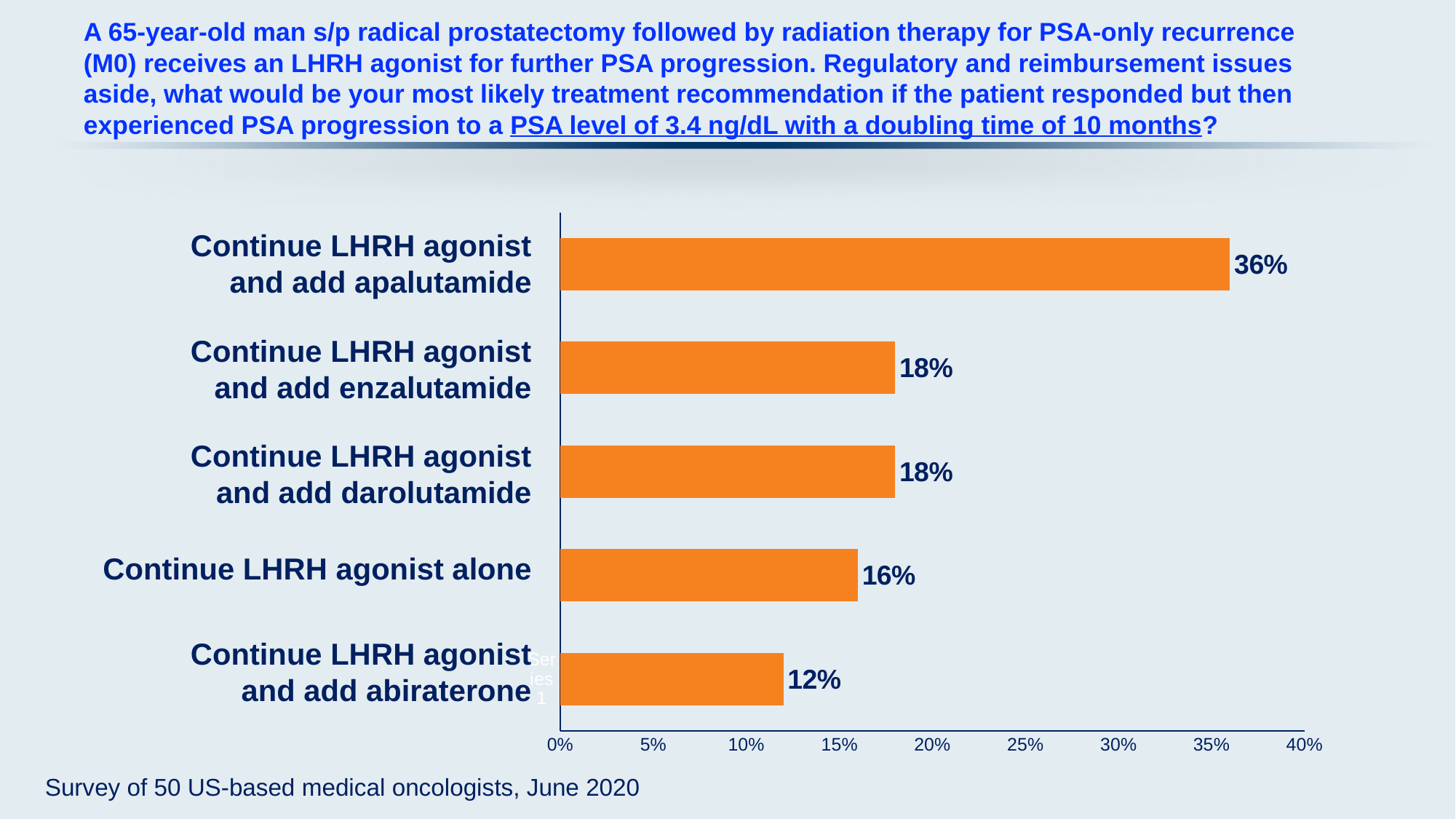
Which treatment recommendation has the lowest percentage? Continue LHRH agonist and add abiraterone What is the maximum value shown on the horizontal axis? 40% What percentage of respondents chose 'Continue LHRH agonist and add apalutamide'? 36% Is the value for 'Continue LHRH agonist and add apalutamide' greater or less than 30%? greater What is the value for 'Continue LHRH agonist and add darolutamide'? 18% What is the value for 'Continue LHRH agonist alone'? 16% Which is larger: the value for 'Continue LHRH agonist alone' or 'Continue LHRH agonist and add abiraterone'? Continue LHRH agonist alone What is the value for 'Continue LHRH agonist and add abiraterone'? 12% How many treatment options are shown in the chart? 5 What kind of chart is shown on the slide? Bar chart Which treatment recommendation has the highest percentage? Continue LHRH agonist and add apalutamide What is the difference between the values for 'Continue LHRH agonist and add apalutamide' and 'Continue LHRH agonist and add enzalutamide'? 18%